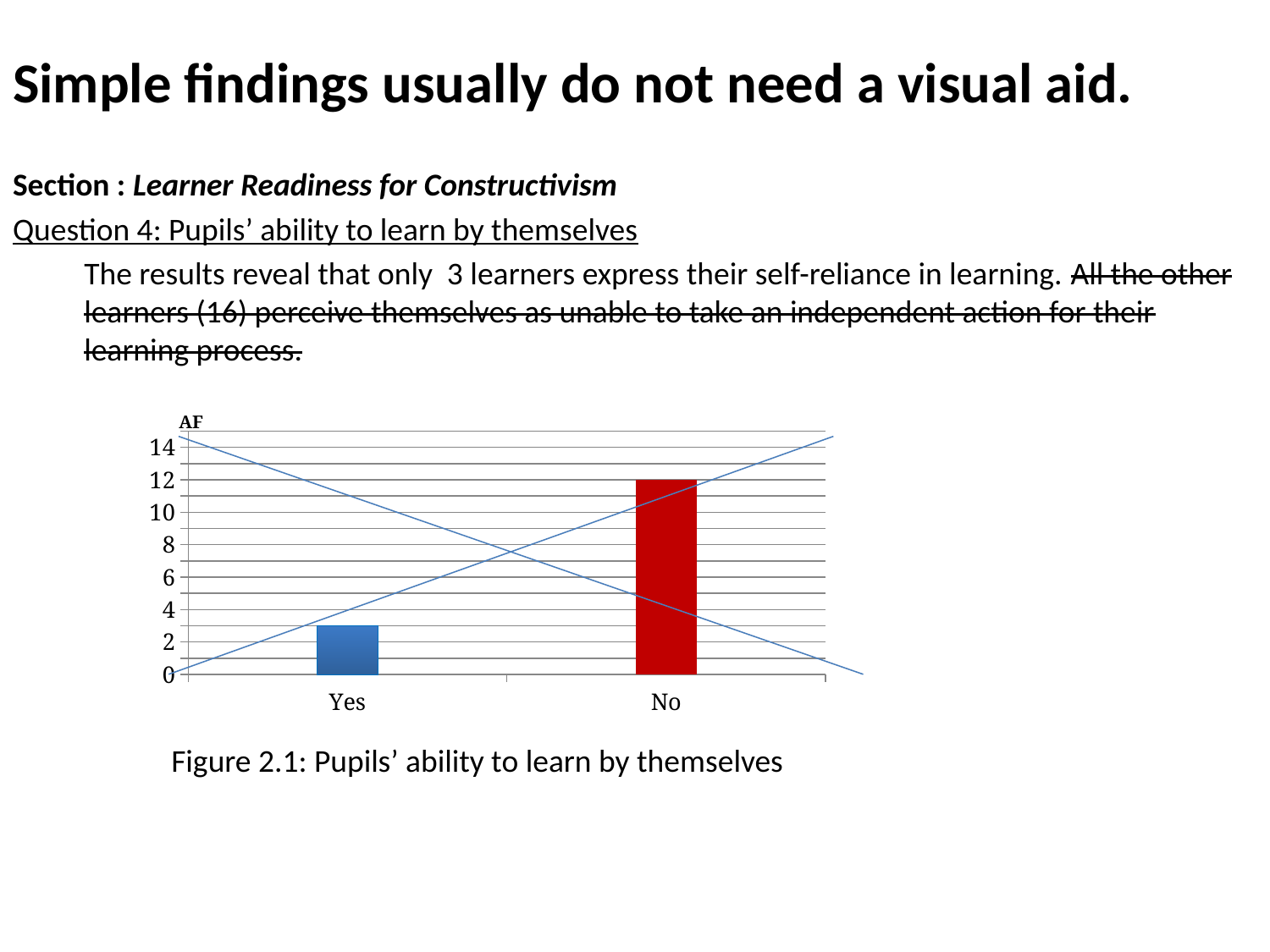
What colour is the bar for No? red What kind of chart is shown on the slide? bar chart Which category has the lowest bar? Yes Is the value for Yes greater or less than 2? greater How many categories are shown on the x axis of the chart? 2 Which bar is taller, Yes or No? No Is the value for Yes greater or less than 4? less Which category has the highest bar? No Is the value for No greater or less than 10? greater What label is shown at the top of the vertical axis of the chart? AF What is the value of the bar for No? 12